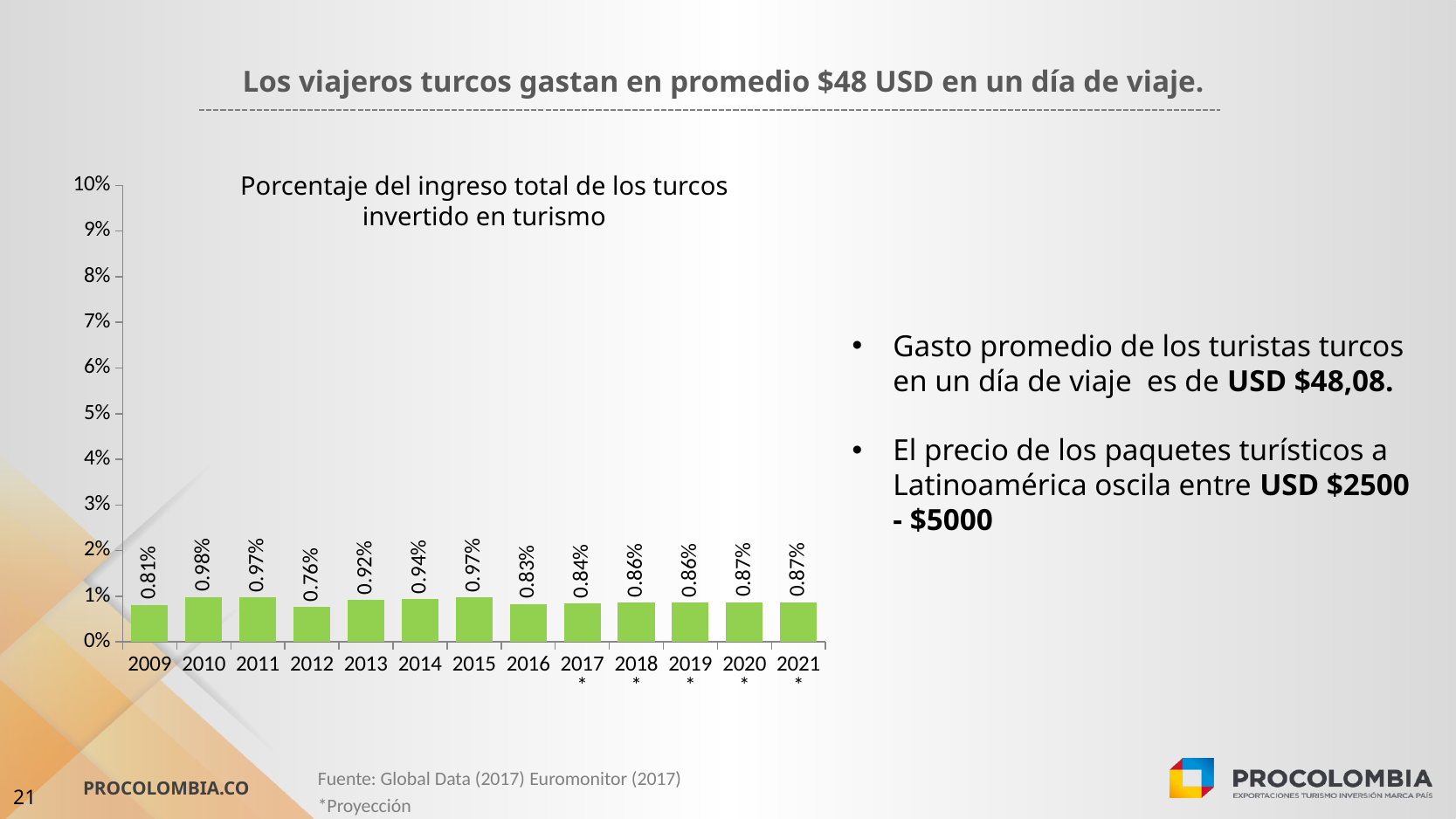
Is the value for 2014 greater or less than 1%? less Which is larger, the value for 2013 or the value for 2016? 2013 What is the value for 2015? 0.97% What is the difference between the values for 2010 and 2012? 0.22% What is the title of the chart? Porcentaje del ingreso total de los turcos invertido en turismo Do the values rise or fall from 2017 to 2021? rise What type of chart is shown on the slide? bar chart What is the value for 2009? 0.81% How many years are shown on the x axis? 13 Which year has the lowest value? 2012 Which year has the highest value? 2010 What is the value for 2021? 0.87%